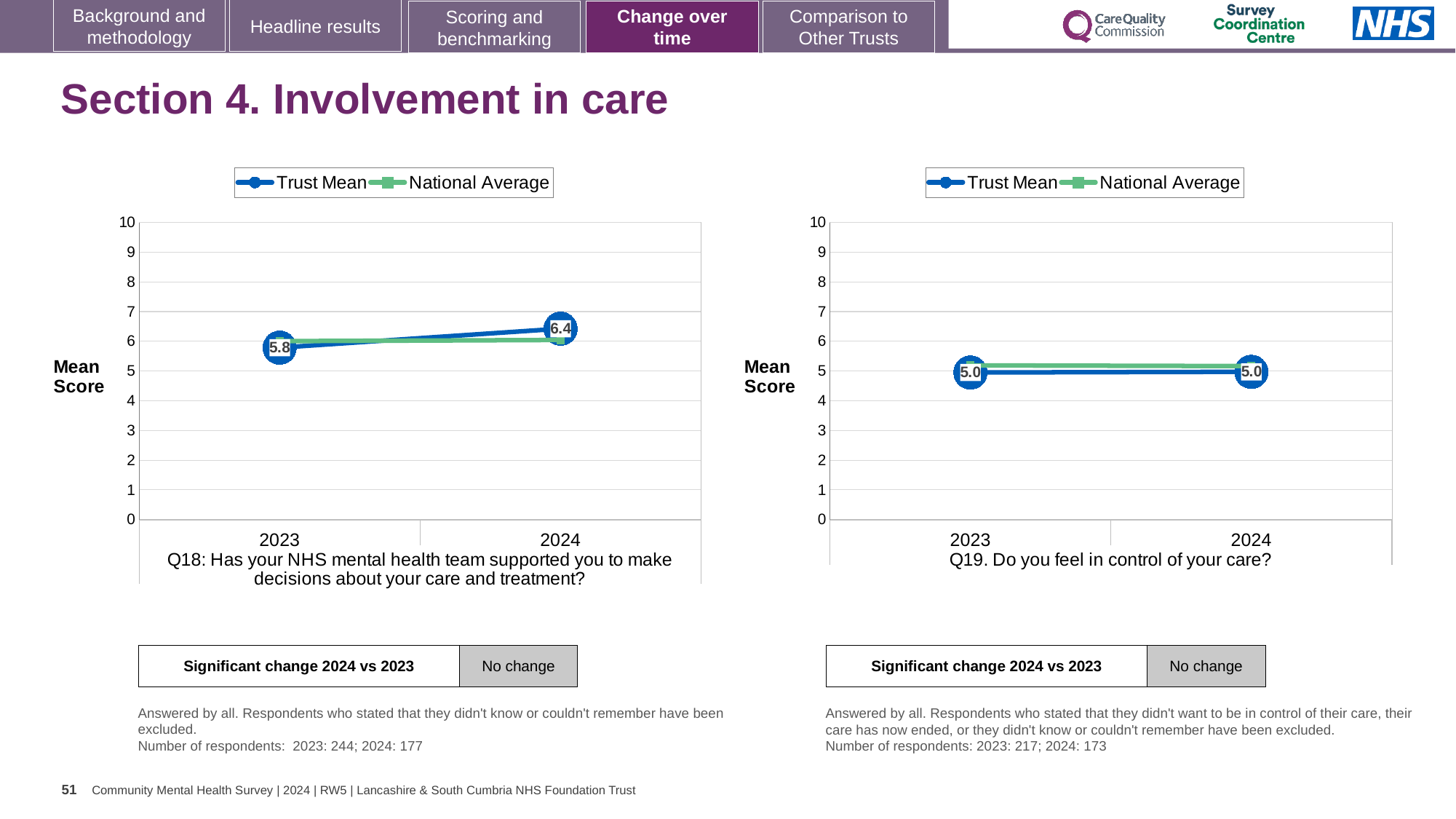
In the Q18 chart on the left, what is the Trust Mean for 2023? 5.8 In the Q19 chart on the right, is the National Average for 2024 greater or less than 7? less How many years are plotted on the x axis of the Q19 chart on the right? 2 In the Q18 chart on the left, does the Trust Mean rise or fall from 2023 to 2024? rise In the Q19 chart on the right, what is the Trust Mean for 2023? 5.0 In the Q18 chart on the left, is the National Average for 2023 greater or less than 5? greater In the Q18 chart on the left, what is the Trust Mean for 2024? 6.4 How many series does the legend of the Q18 chart on the left list? 2 What kind of chart is the Q19 chart on the right? line chart In the Q19 chart on the right, does the Trust Mean rise, fall or stay the same from 2023 to 2024? stay the same In the Q18 chart on the left, is the Trust Mean higher in 2023 or 2024? 2024 In the Q18 chart on the left, by how much did the Trust Mean change from 2023 to 2024? 0.6